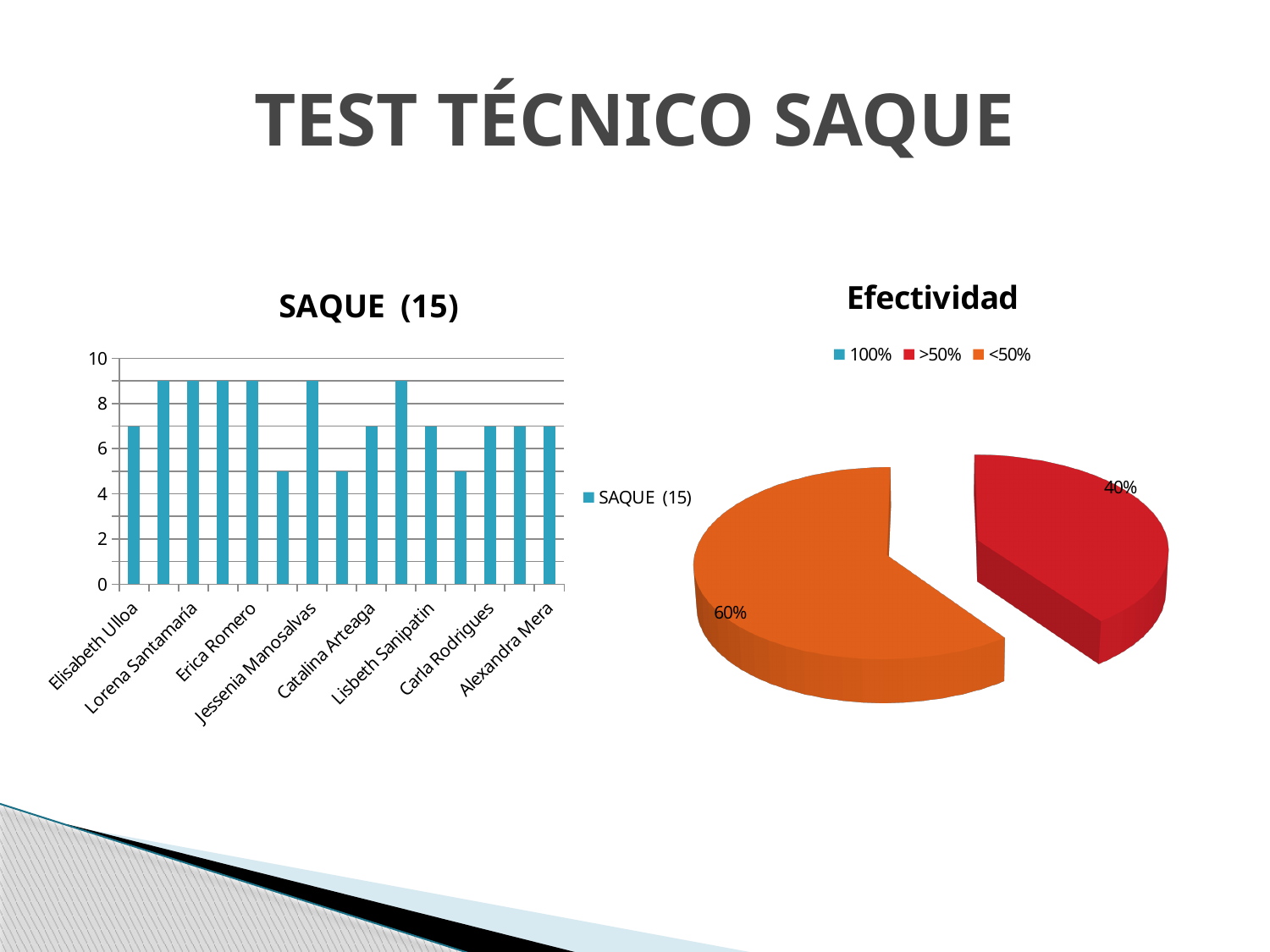
On the Efectividad chart, what kind of chart is it? pie chart On the SAQUE (15) chart, is the value for Lorena Santamaría greater or less than 8? greater On the SAQUE (15) chart, which is larger, the value for Lorena Santamaría or the value for Elisabeth Ulloa? Lorena Santamaría On the SAQUE (15) chart, what kind of chart is it? bar chart On the Efectividad chart, what share of the pie is the <50% slice? 60% On the SAQUE (15) chart, how many series does the legend list? 1 On the Efectividad chart, which slice is the largest? <50% On the Efectividad chart, how many entries does the legend list? 3 On the SAQUE (15) chart, how many bars are plotted? 15 On the Efectividad chart, what is the difference between the <50% slice and the >50% slice? 20% On the SAQUE (15) chart, is the value for Catalina Arteaga greater or less than 8? less On the SAQUE (15) chart, is the value for Elisabeth Ulloa greater or less than 6? greater